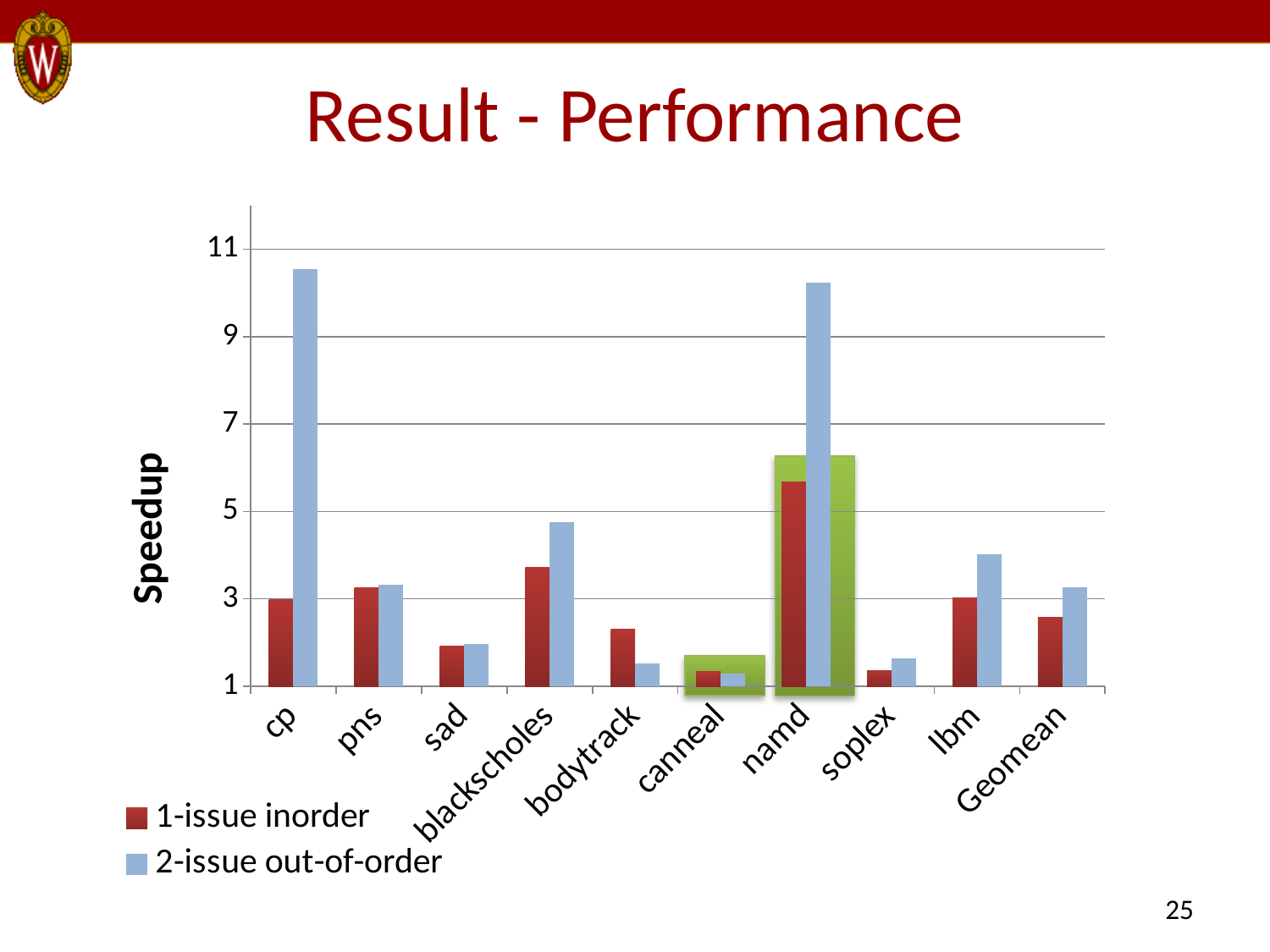
Is the 1-issue inorder value for bodytrack greater or less than 3? less How many series does the legend list? 2 Which series does the blue bar represent? 2-issue out-of-order Is the 2-issue out-of-order value for cp greater or less than 9? greater Which category has the highest 1-issue inorder speedup? namd What is the label of the y axis? Speedup Is the 2-issue out-of-order value for blackscholes greater or less than 5? less How many categories are shown on the x axis? 10 For cp, which series has the larger speedup, 1-issue inorder or 2-issue out-of-order? 2-issue out-of-order For bodytrack, which series has the larger speedup, 1-issue inorder or 2-issue out-of-order? 1-issue inorder What kind of chart is shown on the slide? bar chart